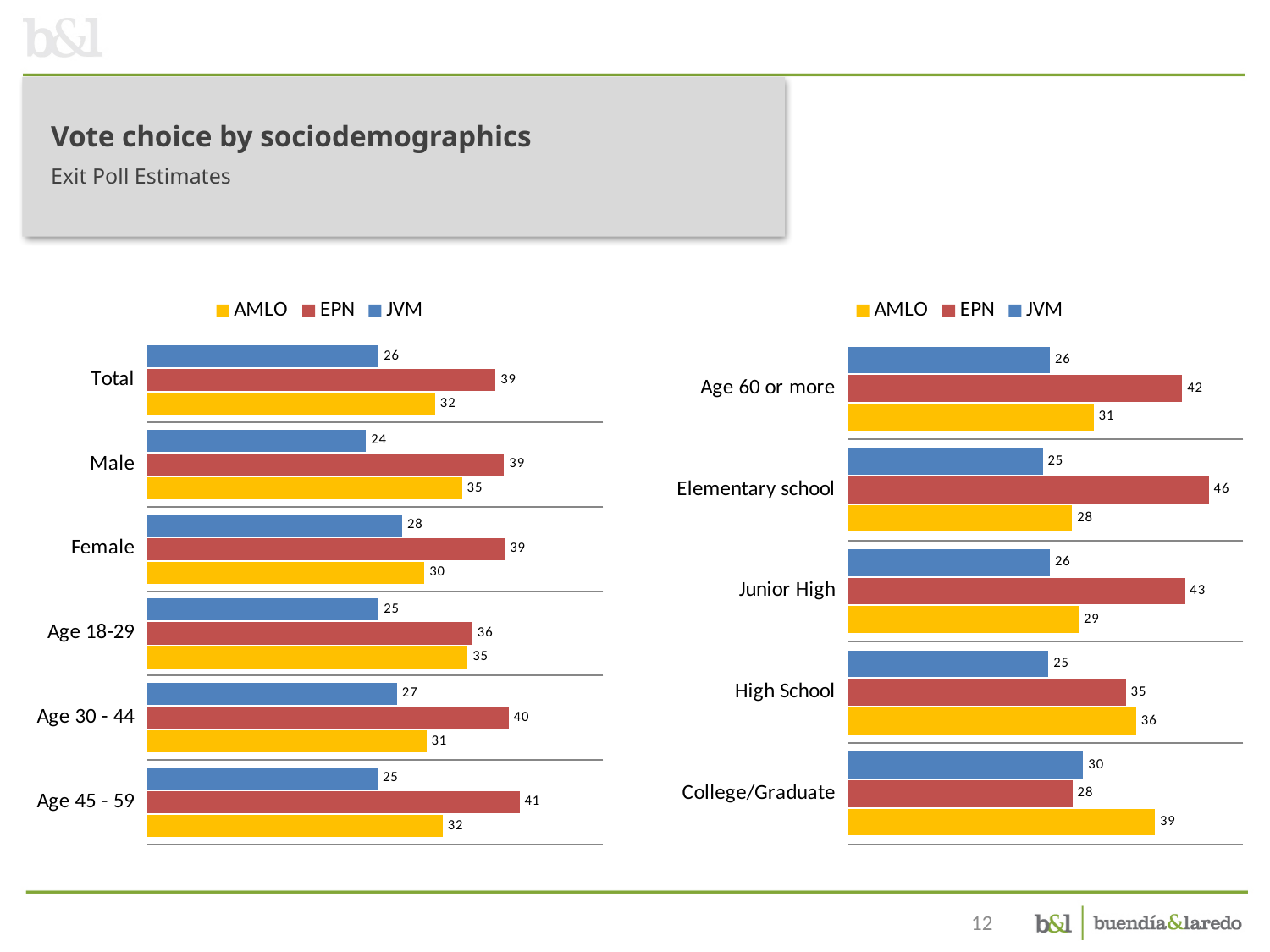
In the left chart, which category has the lowest JVM value? Male In the right chart, which is larger for College/Graduate respondents, EPN or JVM? JVM How many series does the legend of the left chart list? 3 How many categories are shown in the right chart? 5 In the left chart, what is the difference between the EPN and AMLO values for Age 45 - 59? 9 In the right chart, what is the value for AMLO among College/Graduate respondents? 39 In the right chart, which is larger for High School respondents, AMLO or EPN? AMLO In the right chart, what is the value for JVM in the Junior High category? 26 In the left chart, what is the value for EPN in the Total category? 39 In the right chart, which category has the highest EPN value? Elementary school How many categories are shown in the left chart? 6 What type of chart is the right chart? Bar chart